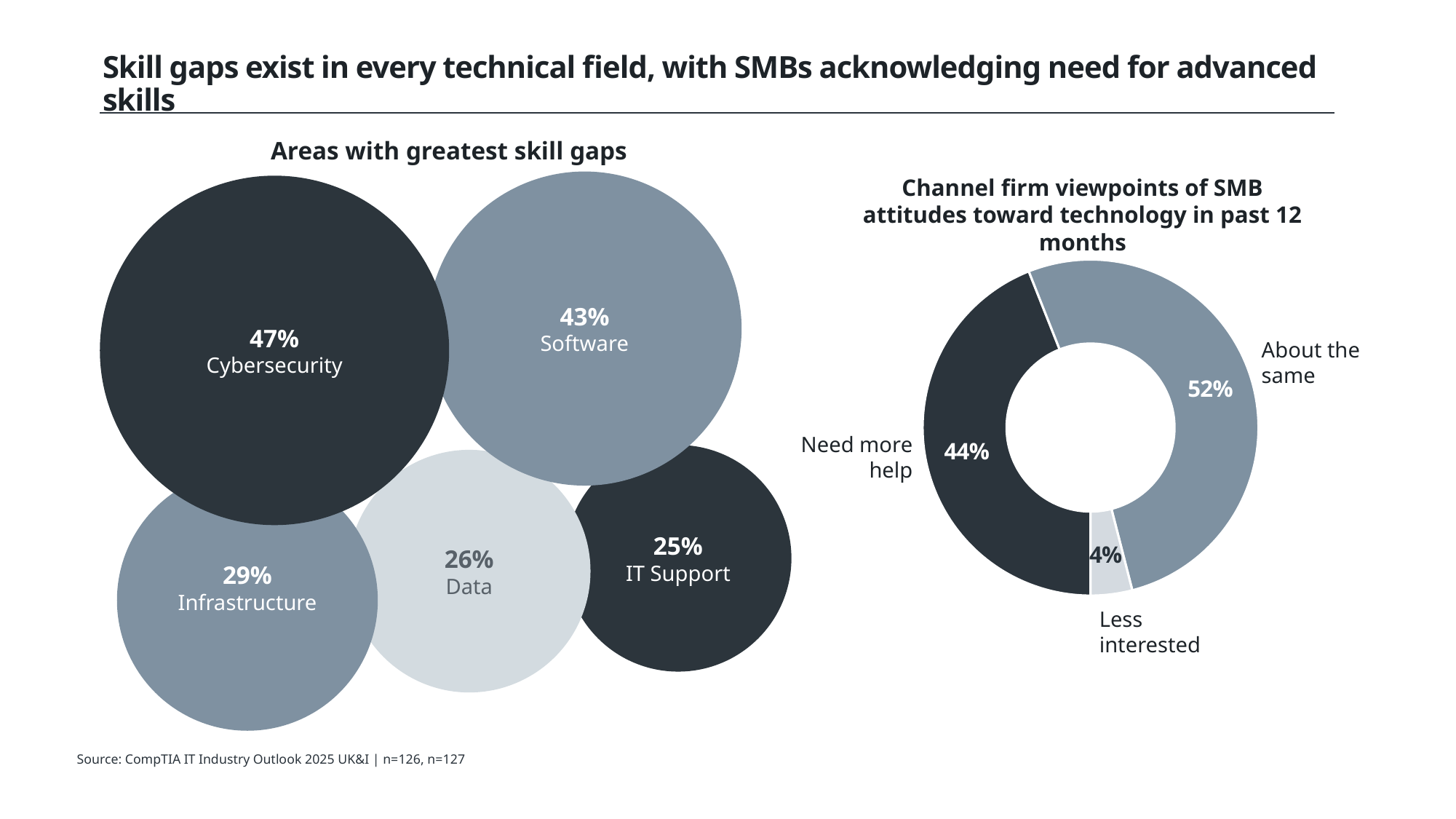
In the 'Channel firm viewpoints of SMB attitudes toward technology in past 12 months' chart, what is the difference between 'About the same' and 'Need more help'? 8 percentage points In the 'Areas with greatest skill gaps' chart, what is the value for Data? 26% How many areas are shown in the 'Areas with greatest skill gaps' chart? 5 In the 'Channel firm viewpoints of SMB attitudes toward technology in past 12 months' chart, what share is 'About the same'? 52% In the 'Areas with greatest skill gaps' chart, which area has the lowest value? IT Support What kind of chart is the 'Channel firm viewpoints of SMB attitudes toward technology in past 12 months' chart? Doughnut chart In the 'Areas with greatest skill gaps' chart, what is the value for Cybersecurity? 47% In the 'Channel firm viewpoints of SMB attitudes toward technology in past 12 months' chart, what is the value for 'Need more help'? 44% In the 'Areas with greatest skill gaps' chart, which is larger: Infrastructure or Data? Infrastructure In the 'Channel firm viewpoints of SMB attitudes toward technology in past 12 months' chart, which category has the smallest share? Less interested In the 'Areas with greatest skill gaps' chart, what is the difference between Cybersecurity and Software? 4 percentage points In the 'Areas with greatest skill gaps' chart, which area has the highest value? Cybersecurity